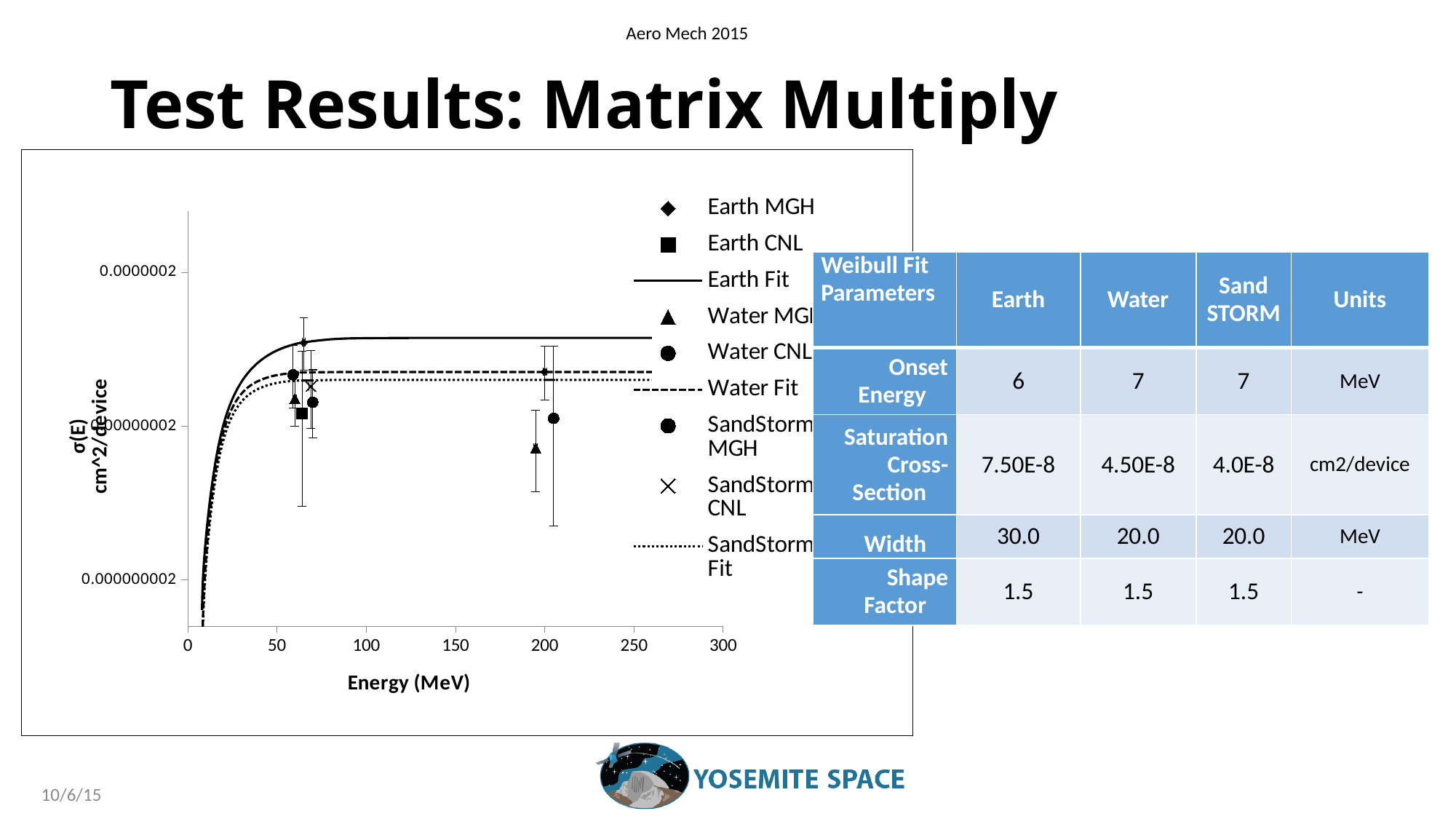
What is the y-axis label of the chart? σ(E) cm^2/device What is the maximum value shown on the x-axis of the chart? 300 How many series does the chart's legend list? 9 Which is higher on the chart, the Earth Fit line or the SandStorm Fit line? Earth Fit Is the Water MGH point near 195 MeV greater or less than 0.00000002? less Is the saturated value of the Earth Fit line greater or less than 0.0000002? less What is the x-axis label of the chart? Energy (MeV) Is the saturated value of the Earth Fit line greater or less than 0.00000002? greater How do the fit lines behave as energy increases from 0 to about 50 MeV? They rise steeply and then level off Which fit line reaches the highest saturation level on the chart? Earth Fit What kind of chart is shown on the slide? Scatter chart with fitted lines